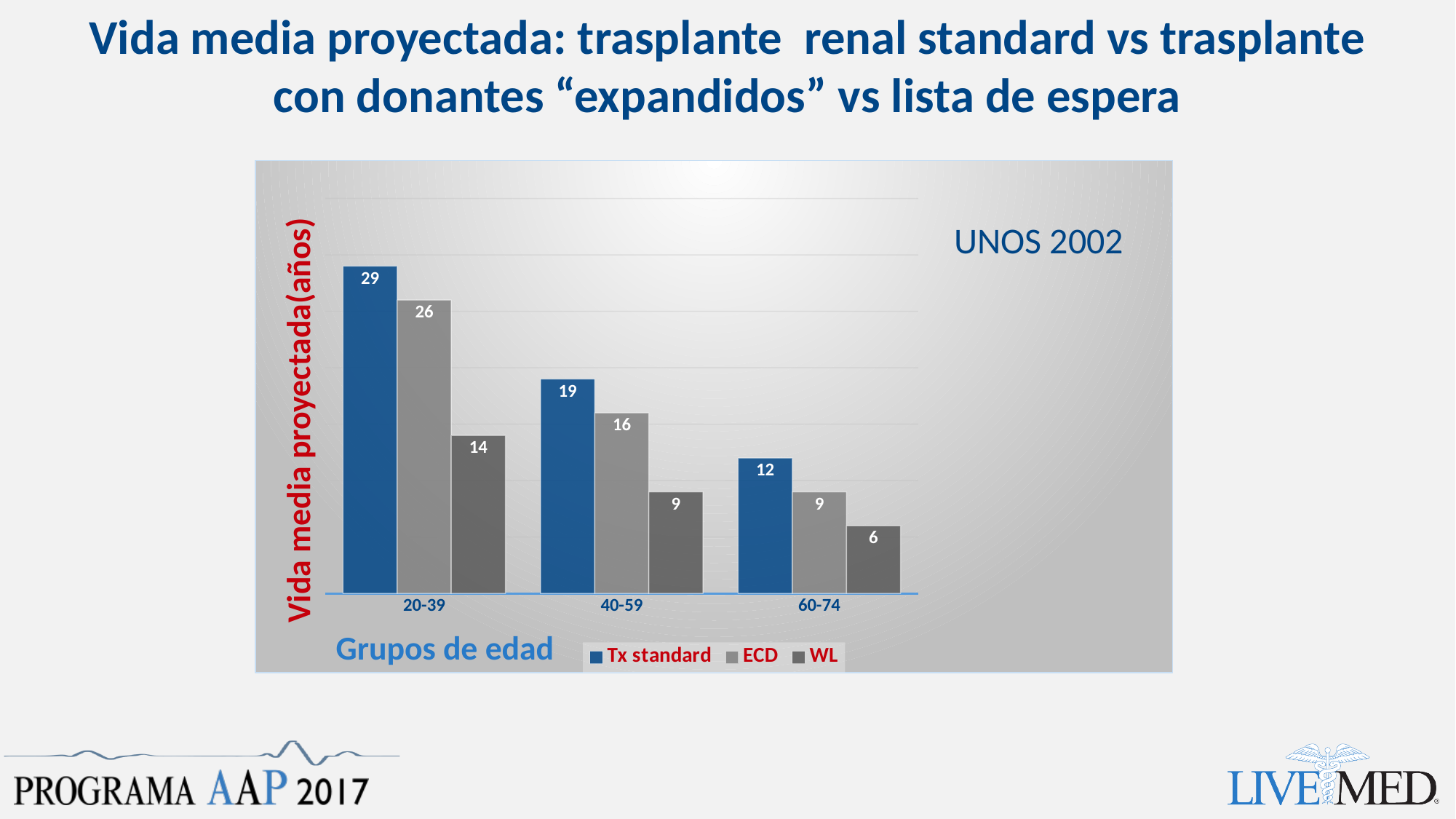
Which age group has the lowest WL value? 60-74 What is the value for ECD in the 40-59 age group? 16 Which age group has the highest Tx standard value? 20-39 Do the Tx standard values rise or fall as the age groups increase along the x axis? Fall How many series does the legend list? 3 What is the difference between the ECD values for the 20-39 and 60-74 age groups? 17 What is the value for WL in the 60-74 age group? 6 What is the difference between the Tx standard and WL values in the 20-39 age group? 15 Which is larger: the WL value for 40-59 or the ECD value for 60-74? They are equal (both 9) What is the projected half-life (Vida media proyectada) for Tx standard in the 20-39 age group? 29 How many age groups are shown on the x axis? 3 What kind of chart is shown on the slide? Bar chart